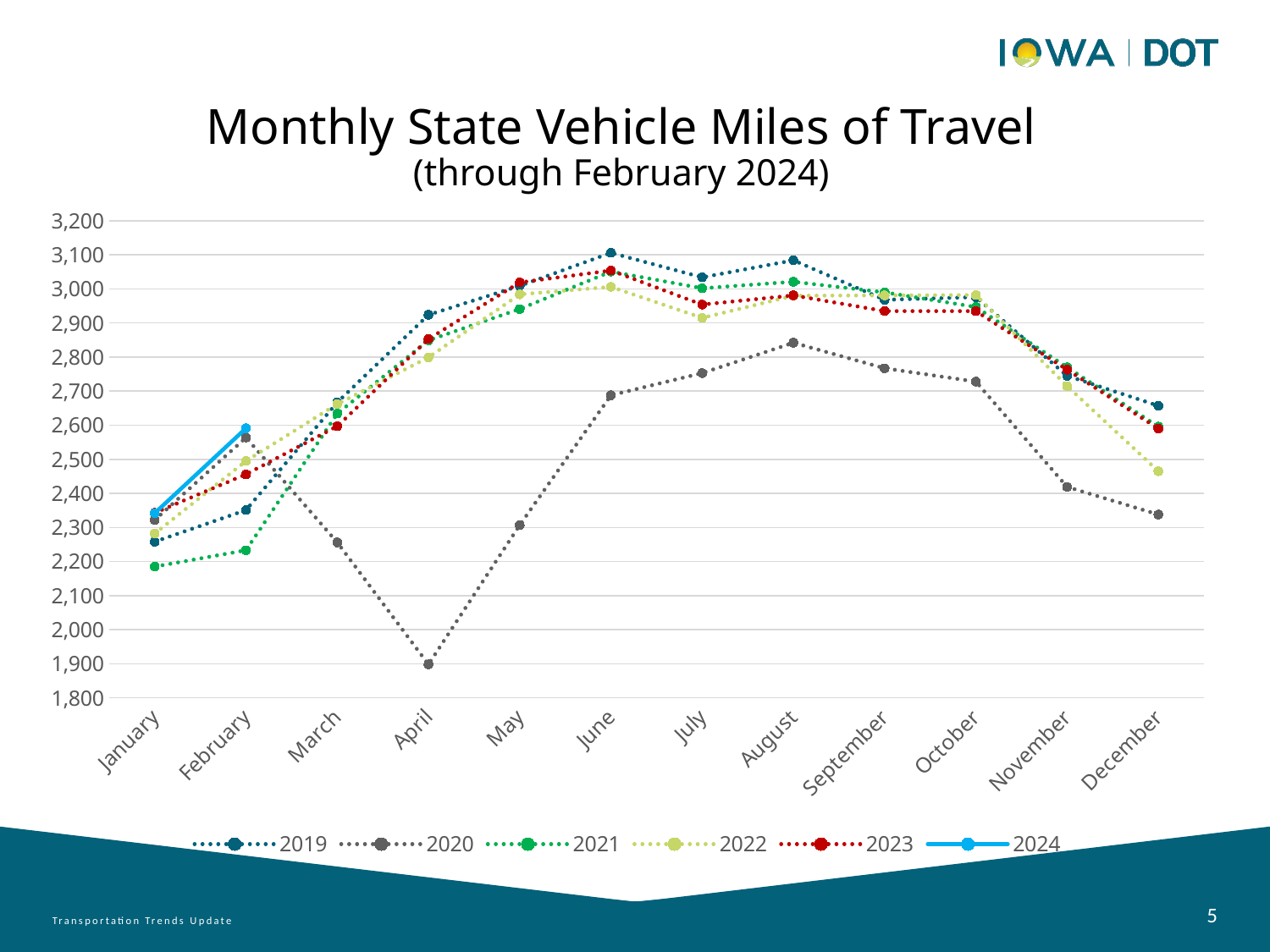
How many months are shown along the x axis? 12 What kind of chart is shown on the slide? line chart Which year's line has the lowest value in April? 2020 How many series does the legend list? 6 Which year is drawn as a solid line rather than a dotted line? 2024 Does the 2024 line rise or fall from January to February? rise In which month does the 2020 line reach its lowest value? April Which year's line has the highest value in June? 2019 Is the value for 2019 in June greater or less than 3,000? greater Is the value for 2024 in February greater or less than 2,500? greater Which is larger in December, the value for 2019 or the value for 2020? 2019 Is the value for 2020 in April greater or less than 2,000? less